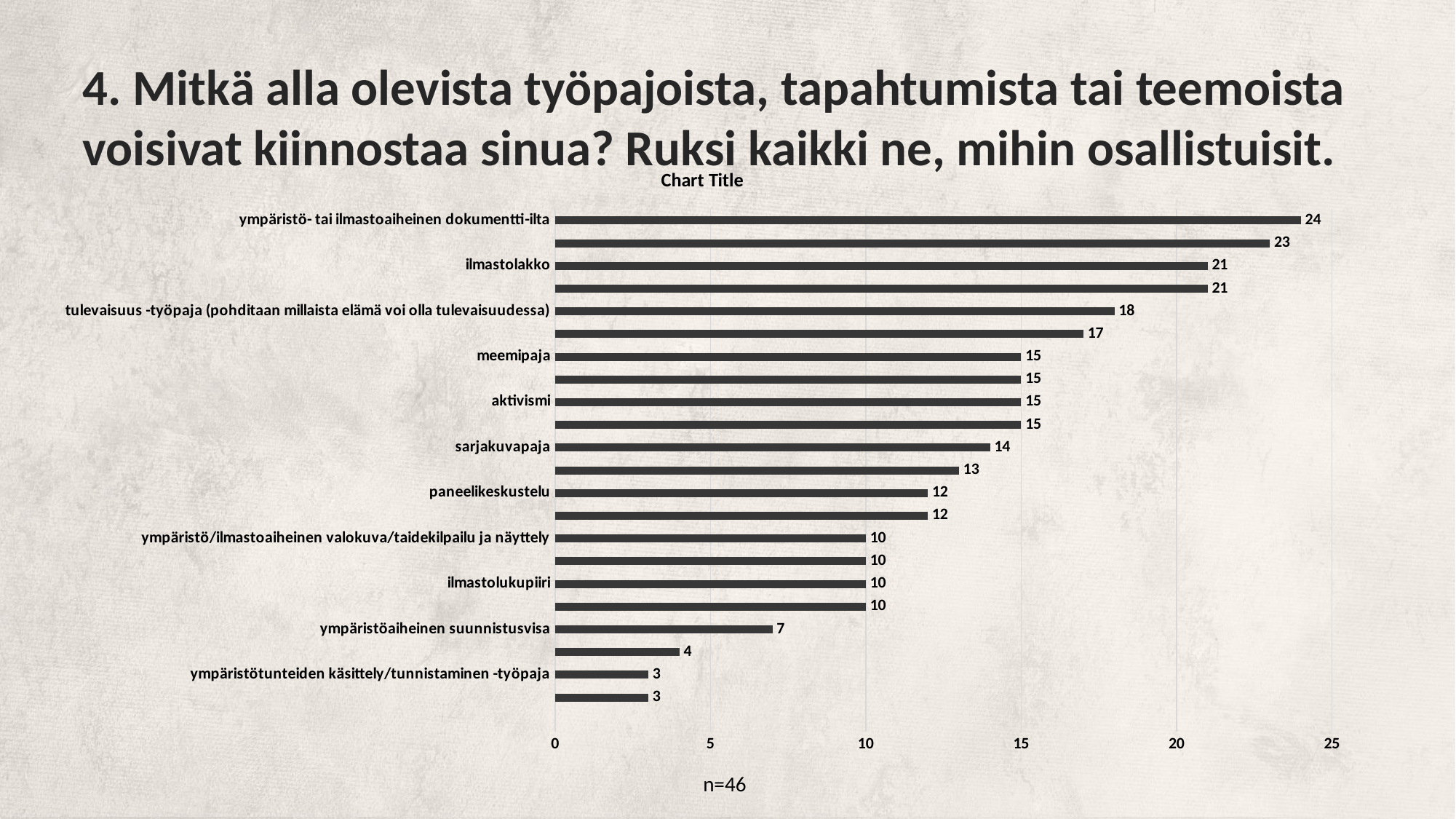
What is the difference between the values for ympäristö- tai ilmastoaiheinen dokumentti-ilta and ilmastolakko? 3 What sample size (n) is stated below the chart? n=46 What is the value for ympäristötunteiden käsittely/tunnistaminen -työpaja? 3 What is the value for ilmastolakko? 21 What is the value for ympäristö- tai ilmastoaiheinen dokumentti-ilta? 24 What is the value for tulevaisuus -työpaja (pohditaan millaista elämä voi olla tulevaisuudessa)? 18 What is the value for ympäristöaiheinen suunnistusvisa? 7 Which labelled category has the highest value? ympäristö- tai ilmastoaiheinen dokumentti-ilta What kind of chart is shown on the slide? bar chart How many bars are plotted in the chart? 22 Is the value for tulevaisuus -työpaja greater or less than 15? greater Which has a larger value, sarjakuvapaja or paneelikeskustelu? sarjakuvapaja